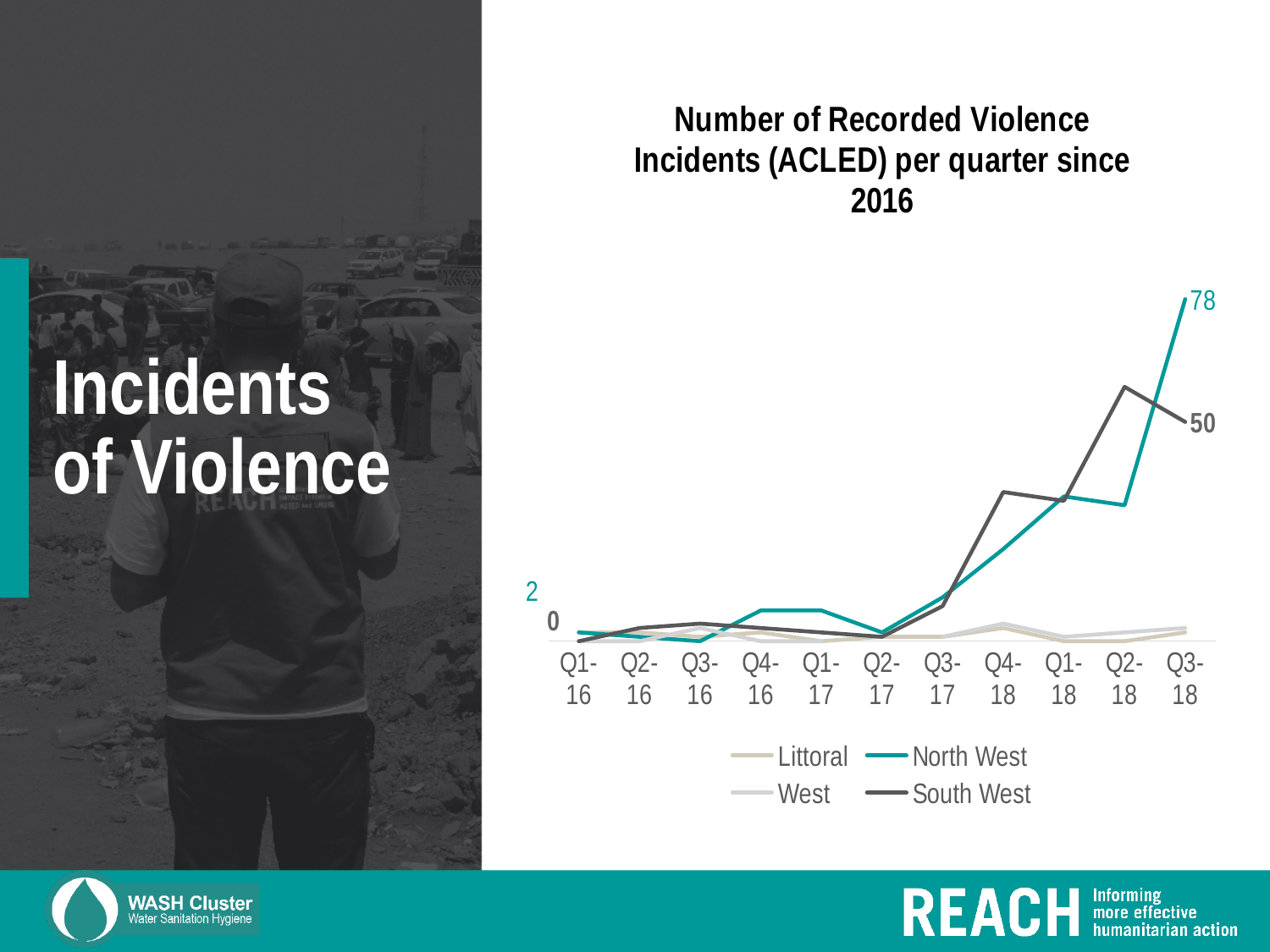
What is the value for South West in Q3-18? 50 What is the difference between the North West and South West values in Q3-18? 28 What type of chart is shown on the slide? Line chart Does the North West series overall rise or fall from Q1-16 to Q3-18? Rise Which series has the highest value in Q3-18? North West How many series does the legend list? 4 What is the title of the chart? Number of Recorded Violence Incidents (ACLED) per quarter since 2016 Which series are listed in the legend? Littoral, North West, West, South West What is the value for North West in Q1-16? 2 How many quarters are shown on the x axis? 11 What is the value for South West in Q1-16? 0 What is the value for North West in Q3-18? 78